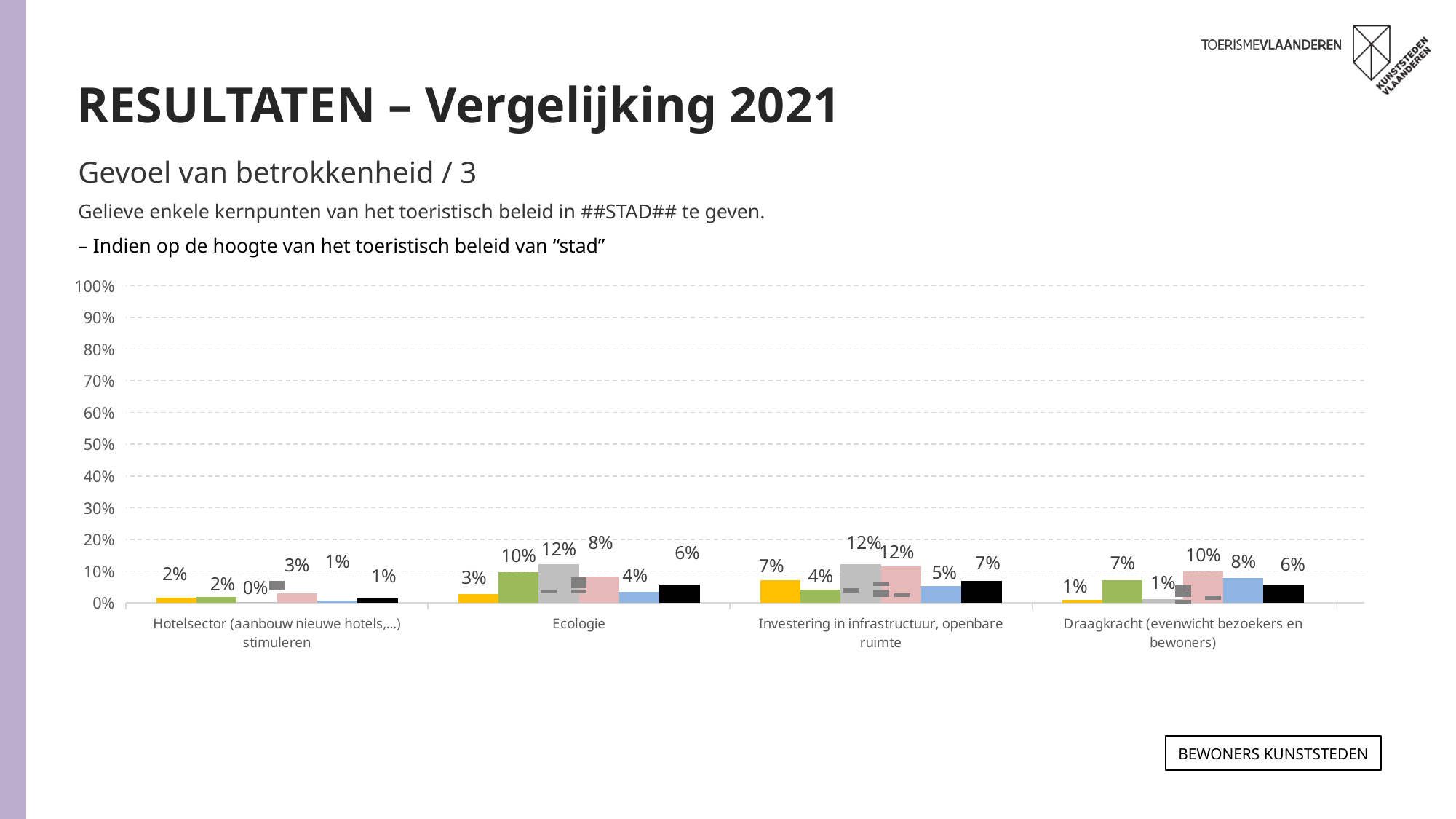
What is the highest value shown on the y axis of the chart? 100% What is the value of the black bar for Ecologie? 6% How many categories are shown on the x axis of the chart? 4 What is the value of the pink bar for Draagkracht (evenwicht bezoekers en bewoners)? 10% What is the value of the yellow bar for Investering in infrastructuur, openbare ruimte? 7% Which category has the lowest value for the blue bar? Hotelsector (aanbouw nieuwe hotels,...) stimuleren What is the difference between the grey bar for Ecologie and the grey bar for Draagkracht (evenwicht bezoekers en bewoners)? 11% What is the value of the grey bar for Hotelsector (aanbouw nieuwe hotels,...) stimuleren? 0% What kind of chart is shown on the slide? bar chart Which is larger: the blue bar for Draagkracht (evenwicht bezoekers en bewoners) or the blue bar for Ecologie? Draagkracht (evenwicht bezoekers en bewoners) Which category has the highest value for the green bar? Ecologie Is the value of the pink bar for Investering in infrastructuur, openbare ruimte greater or less than 10%? greater